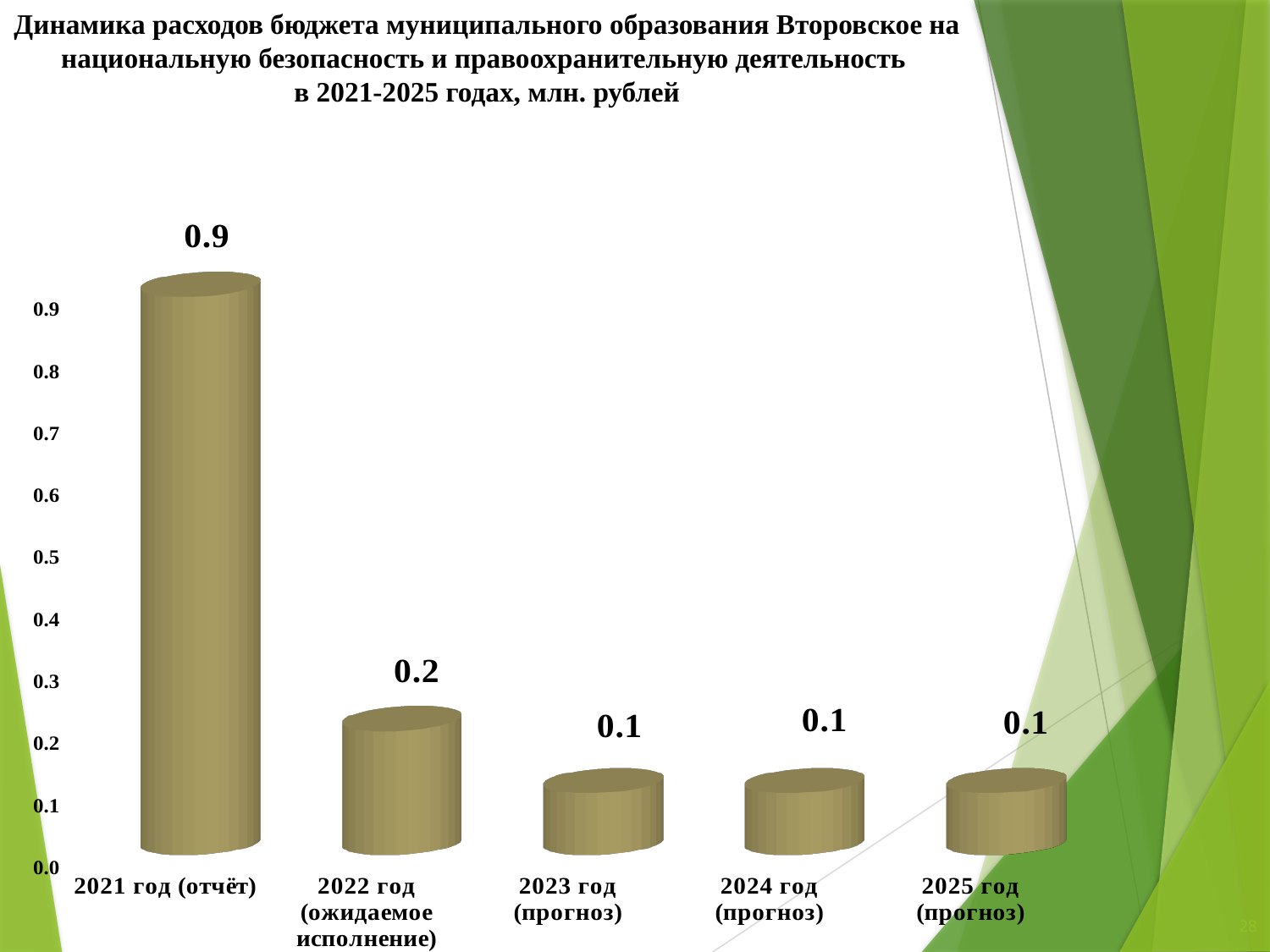
Is the value for 2021 год (отчёт) greater or less than 0.5? greater What kind of chart is shown on the slide? bar chart What is the value for 2021 год (отчёт)? 0.9 What is the difference between the values for 2022 год (ожидаемое исполнение) and 2023 год (прогноз)? 0.1 Which year has the highest value? 2021 год (отчёт) How many categories are shown on the chart? 5 What is the value for 2024 год (прогноз)? 0.1 What is the difference between the values for 2021 год (отчёт) and 2022 год (ожидаемое исполнение)? 0.7 Do the values rise or fall from 2021 to 2023? fall Which is larger, the value for 2021 год (отчёт) or the value for 2025 год (прогноз)? 2021 год (отчёт) In what units are the values on the chart expressed, according to the title? млн. рублей What is the value for 2022 год (ожидаемое исполнение)? 0.2